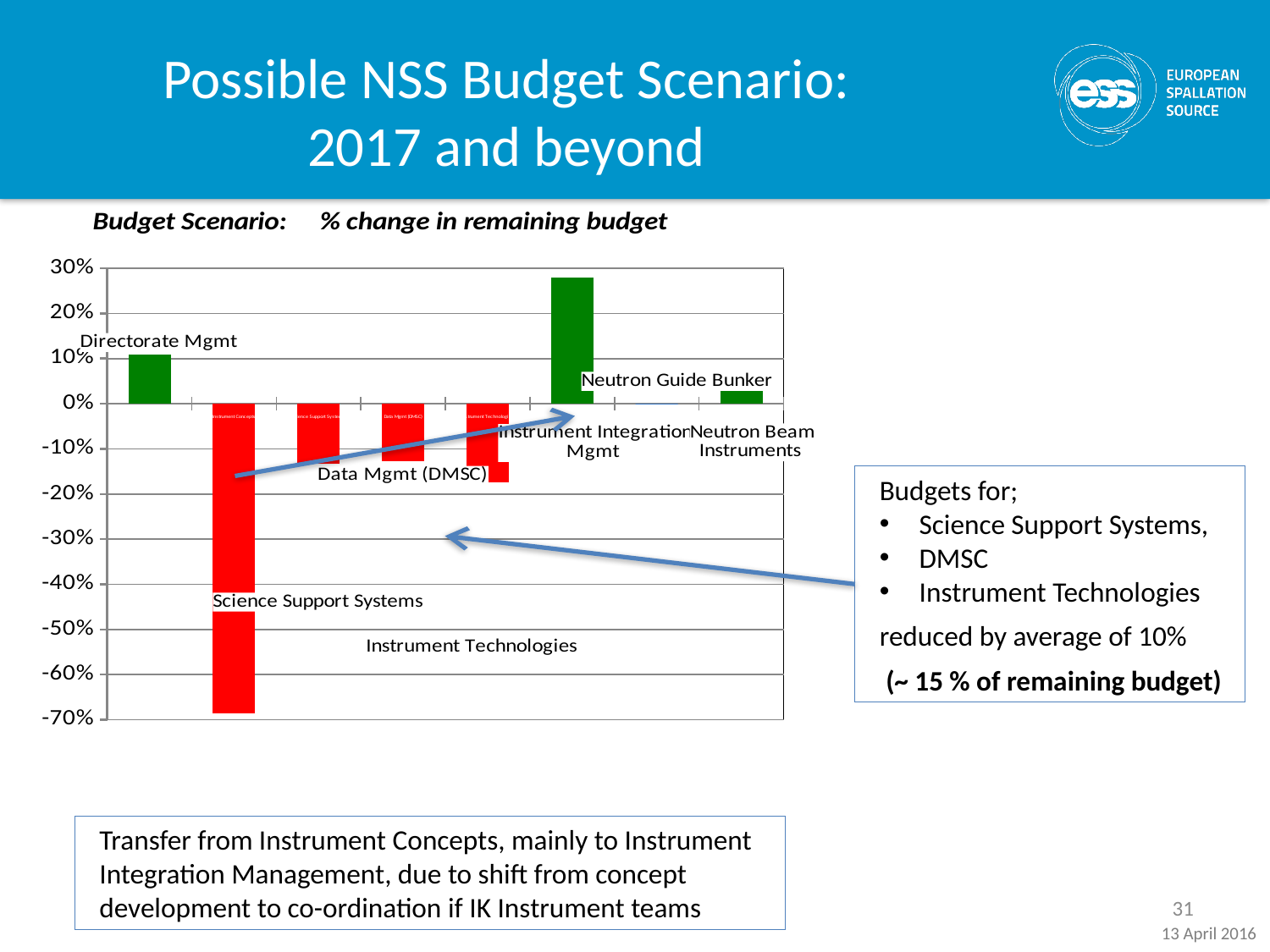
Which category has the highest % change in remaining budget? Instrument Integration Mgmt How many red (negative) bars are in the chart? 4 Is the value for Instrument Integration Mgmt greater or less than 20%? greater What kind of chart is shown on the slide? Bar chart Is the % change for Data Mgmt (DMSC) positive or negative? negative What is the lowest value shown on the vertical axis? -70% What is the title of the chart? Budget Scenario: % change in remaining budget Which is larger, the value for Data Mgmt (DMSC) or the value for Directorate Mgmt? Directorate Mgmt Is the value for Directorate Mgmt greater or less than 20%? less Is the value for Data Mgmt (DMSC) greater or less than -10%? less Which is larger, the value for Instrument Integration Mgmt or the value for Directorate Mgmt? Instrument Integration Mgmt